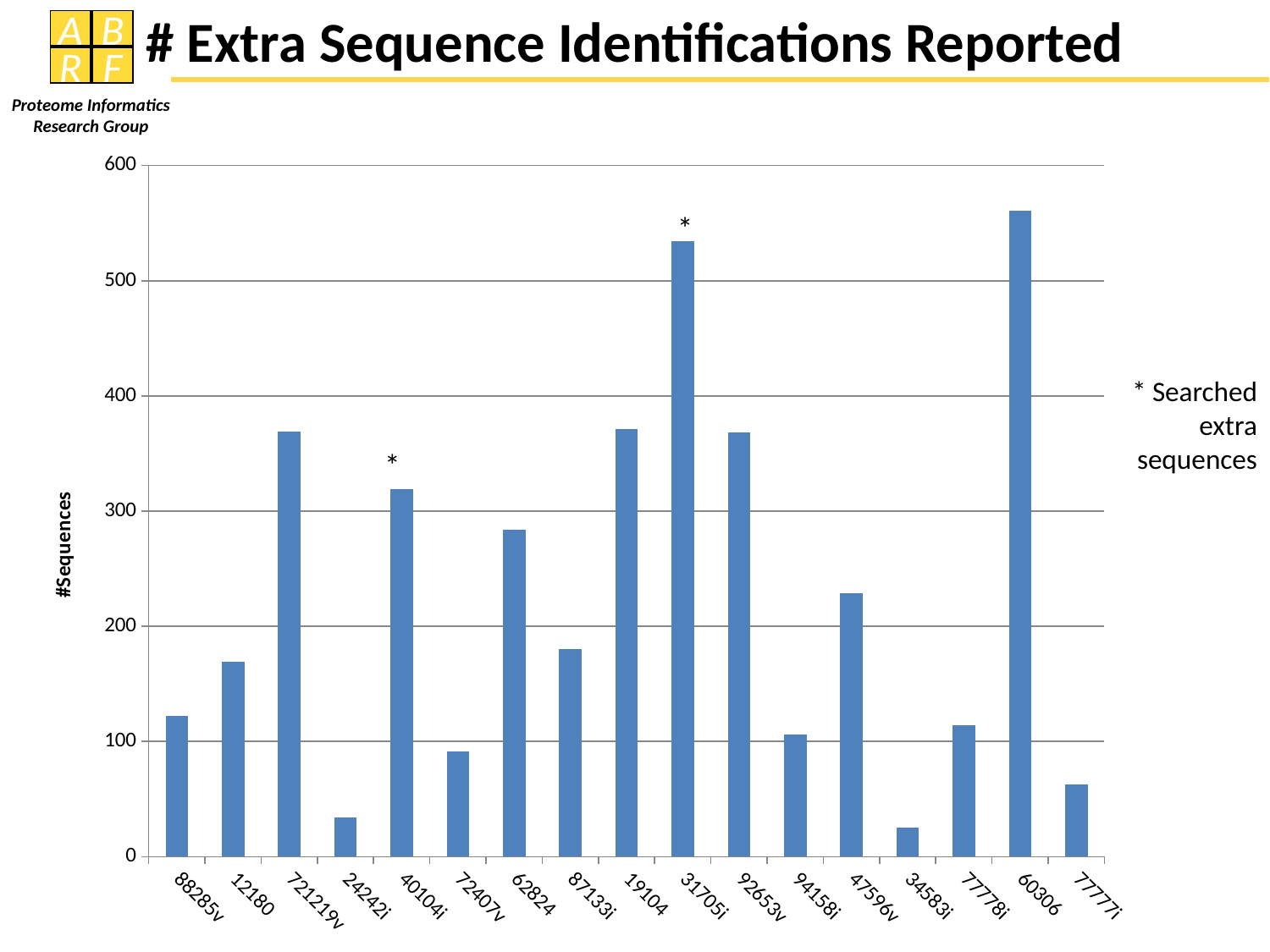
What is the label of the y axis? #Sequences Is the value for 31705i greater or less than 500? greater Is the value for 24242i greater or less than 50? less How many categories are plotted along the x axis? 17 Is the value for 721219v greater or less than 300? greater Which category has the highest number of sequences? 60306 Which has a larger value, 12180 or 88285v? 12180 According to the note on the slide, what does the asterisk above a bar indicate? Searched extra sequences Which has a larger value, 31705i or 40104i? 31705i What kind of chart is shown on the slide? bar chart